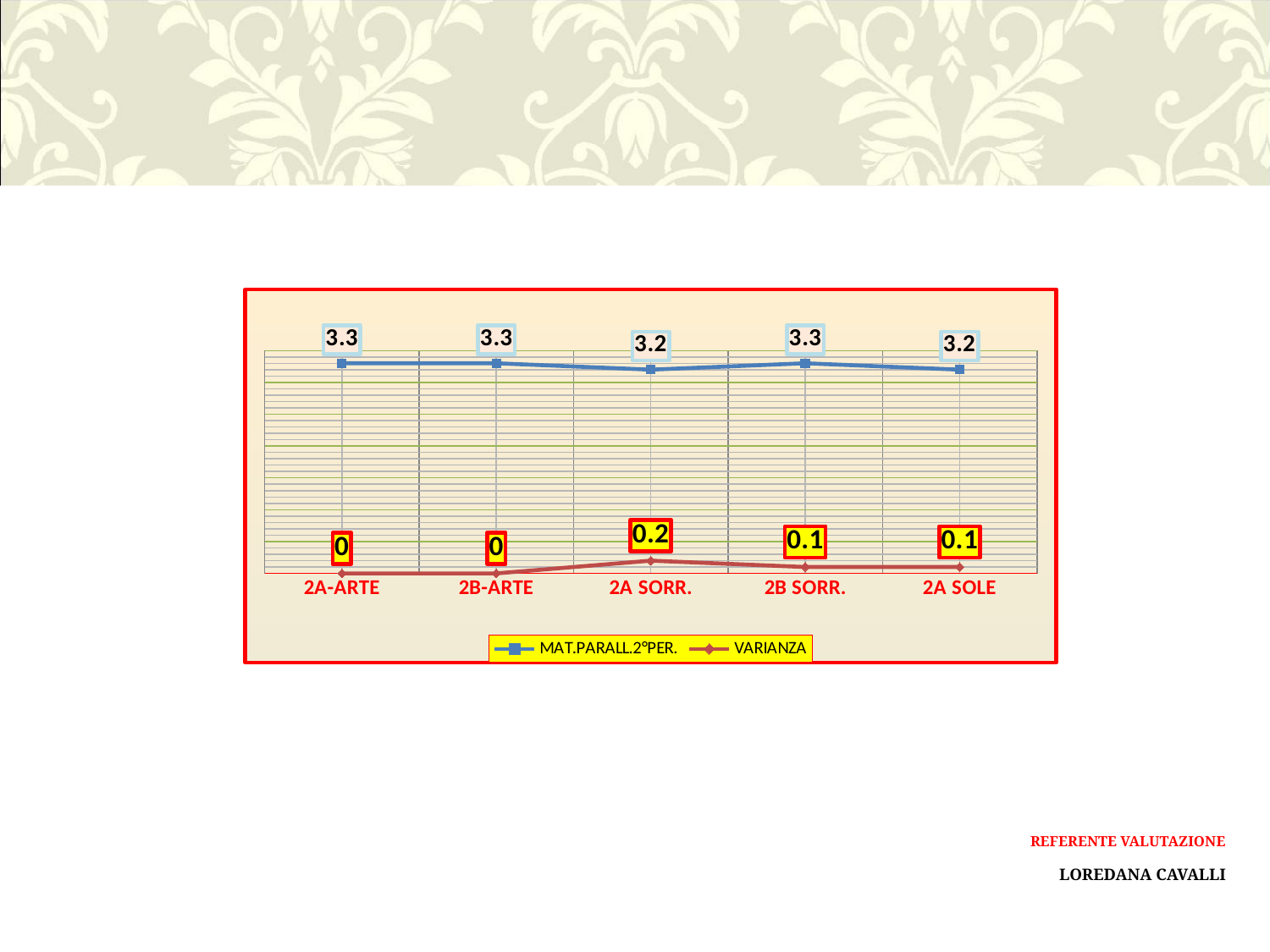
Which is larger, the MAT.PARALL.2°PER. value for 2B SORR. or for 2A SOLE? 2B SORR. What is the difference between the MAT.PARALL.2°PER. values for 2A-ARTE and 2A SOLE? 0.1 How many series does the legend list? 2 What are the two series names listed in the legend? MAT.PARALL.2°PER. and VARIANZA Which category has the highest VARIANZA value? 2A SORR. What is the difference between the VARIANZA values for 2A SORR. and 2B SORR.? 0.1 What is the MAT.PARALL.2°PER. value for 2B-ARTE? 3.3 What is the VARIANZA value for 2A SORR.? 0.2 What is the VARIANZA value for 2B SORR.? 0.1 What kind of chart is shown on the slide? Line chart How many categories are shown on the x axis? 5 What is the MAT.PARALL.2°PER. value for 2A SORR.? 3.2